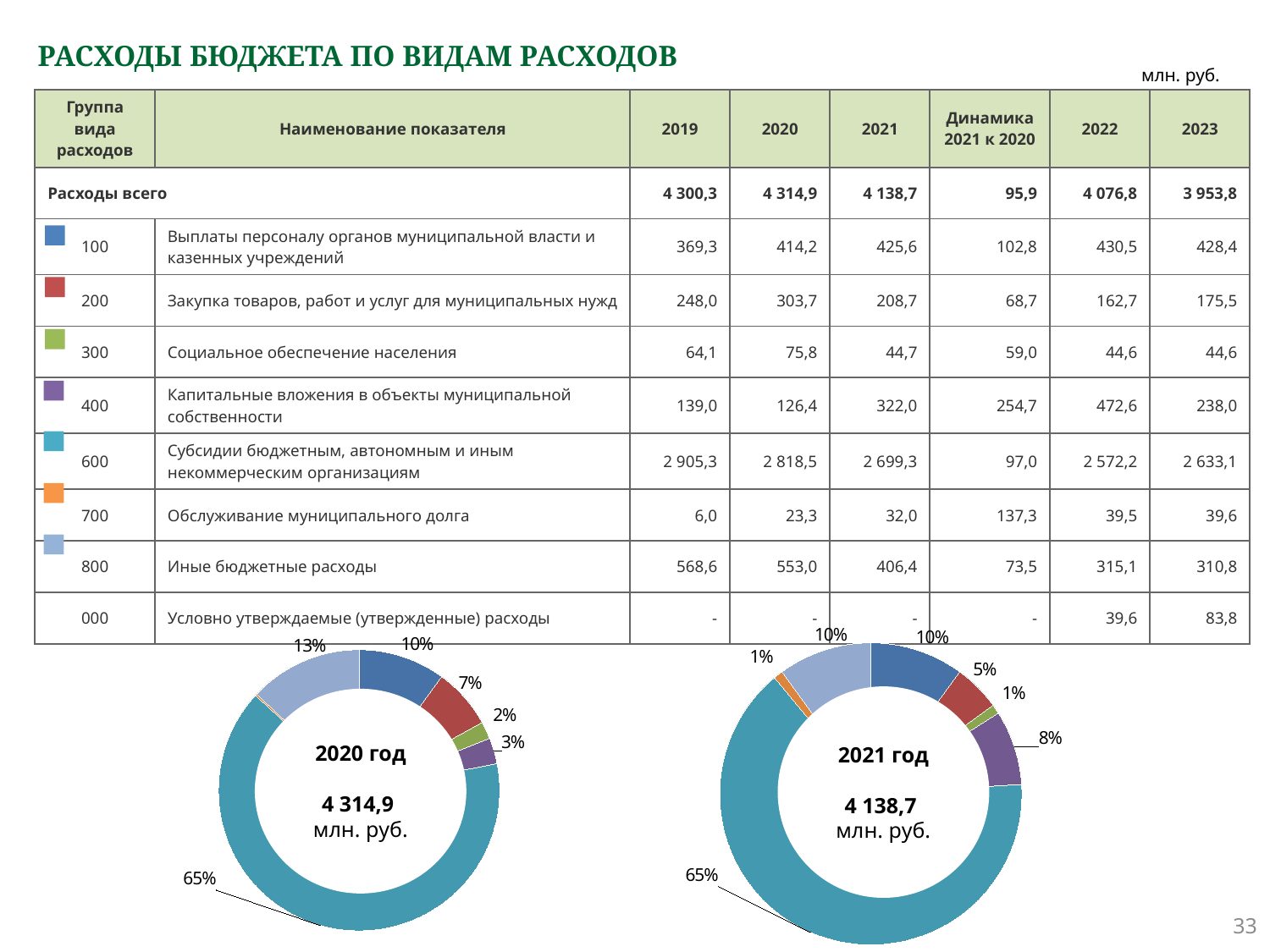
In the 2021 год chart, what share is labelled for the purple slice (group 400)? 8% In the 2020 год chart, what total value is shown in the centre? 4 314,9 млн. руб. In the 2021 год chart, what share is labelled for the red slice (group 200)? 5% In the 2020 год chart, what share is labelled for the light blue slice (group 800)? 13% What kind of chart is shown for 2020 год? doughnut chart Which slice is the largest in the 2021 год chart? the teal slice (group 600), 65% In the 2021 год chart, what total value is shown in the centre? 4 138,7 млн. руб. Is the share of the red slice (group 200) larger in the 2020 год chart or the 2021 год chart? 2020 год How many doughnut charts are shown on the slide? 2